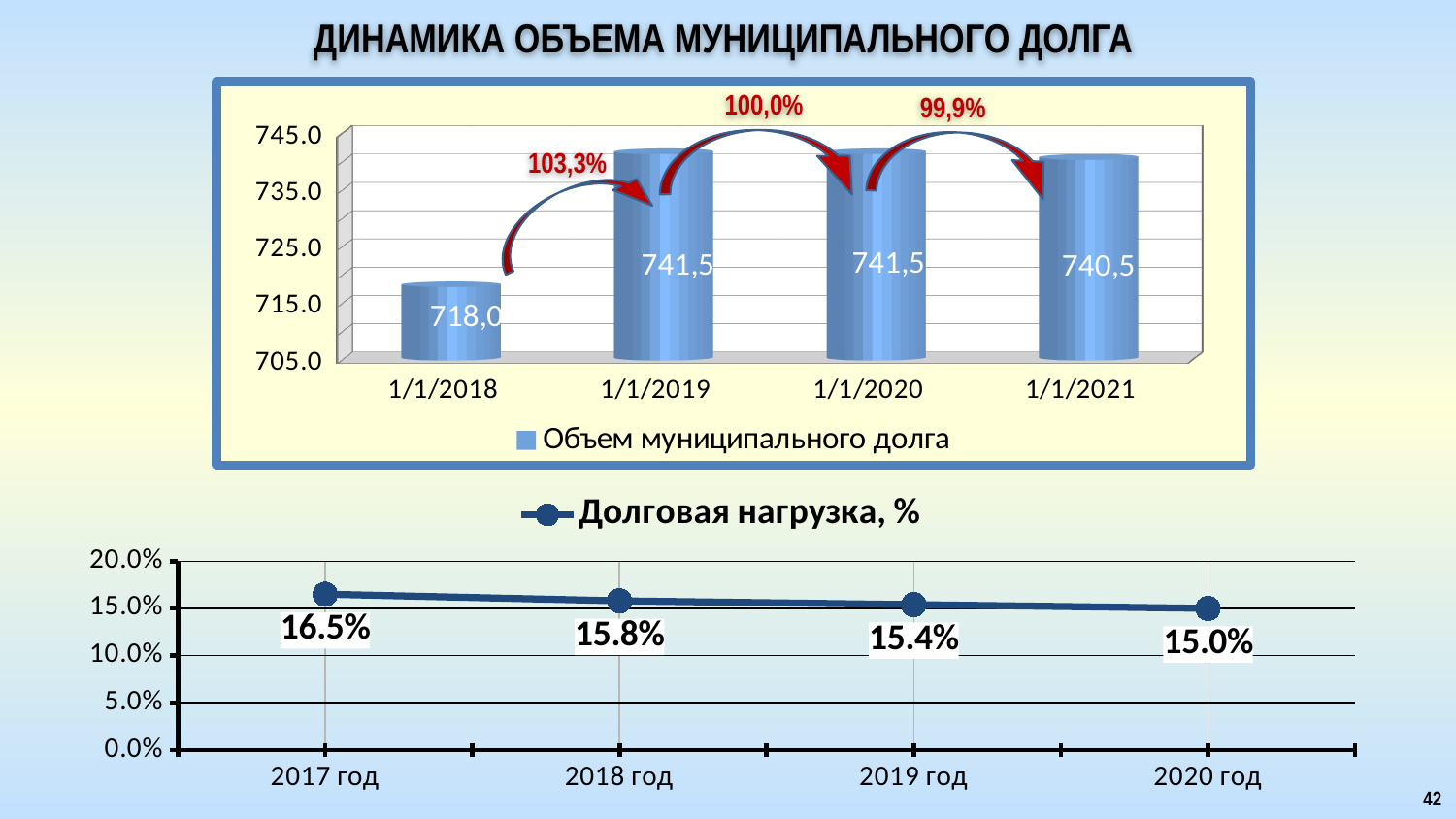
In the bottom chart (Долговая нагрузка, %), which year has the highest value? 2017 год In the top chart (Объем муниципального долга), what is the value for 1/1/2018? 718,0 In the bottom chart (Долговая нагрузка, %), do the values rise or fall from 2017 год to 2020 год? Fall What kind of chart is the top chart (Объем муниципального долга)? Bar chart In the top chart (Объем муниципального долга), what is the difference between the values for 1/1/2019 and 1/1/2018? 23,5 What kind of chart is the bottom chart (Долговая нагрузка, %)? Line chart In the top chart (Объем муниципального долга), how many bars are plotted? 4 In the top chart (Объем муниципального долга), which is larger: the value for 1/1/2020 or for 1/1/2021? 1/1/2020 In the bottom chart (Долговая нагрузка, %), what is the difference between the values for 2017 год and 2020 год? 1.5% In the top chart (Объем муниципального долга), what is the value for 1/1/2021? 740,5 In the top chart (Объем муниципального долга), which date has the lowest value? 1/1/2018 In the bottom chart (Долговая нагрузка, %), what is the value for 2018 год? 15.8%